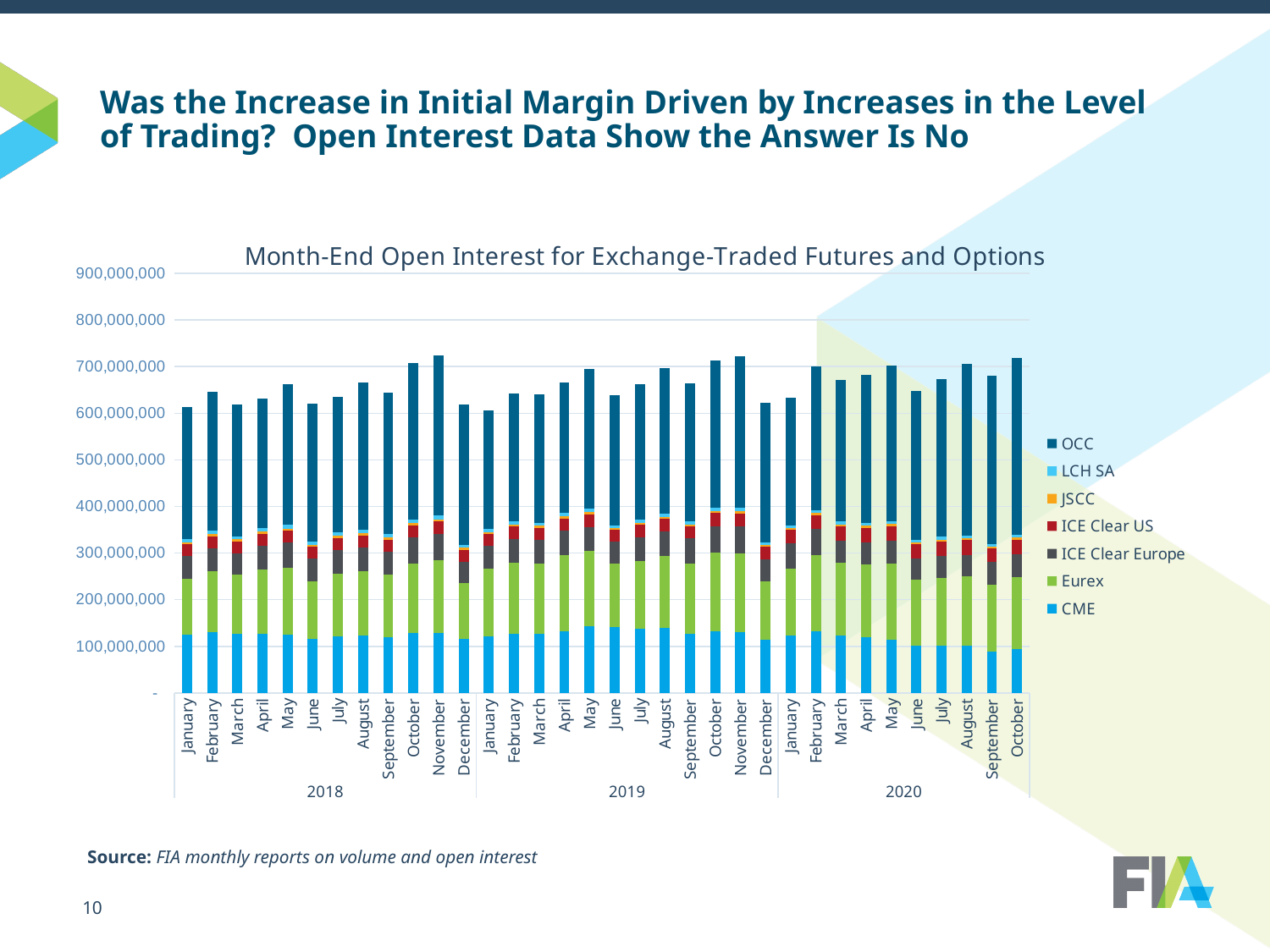
Which series is plotted at the bottom of each stacked bar? CME Is the total open interest for November 2018 greater or less than 700,000,000? greater Is the total open interest for January 2019 greater or less than 700,000,000? less How many monthly bars are plotted in the chart? 34 Which month has the larger total open interest, October 2018 or December 2018? October 2018 How many series does the legend list? 7 Which month has the larger total open interest, November 2018 or January 2019? November 2018 What kind of chart is shown on the slide? Stacked bar chart Is the total open interest for January 2018 greater or less than 700,000,000? less Do the CME values rise or fall from January 2020 to October 2020? fall What is the title of the chart? Month-End Open Interest for Exchange-Traded Futures and Options